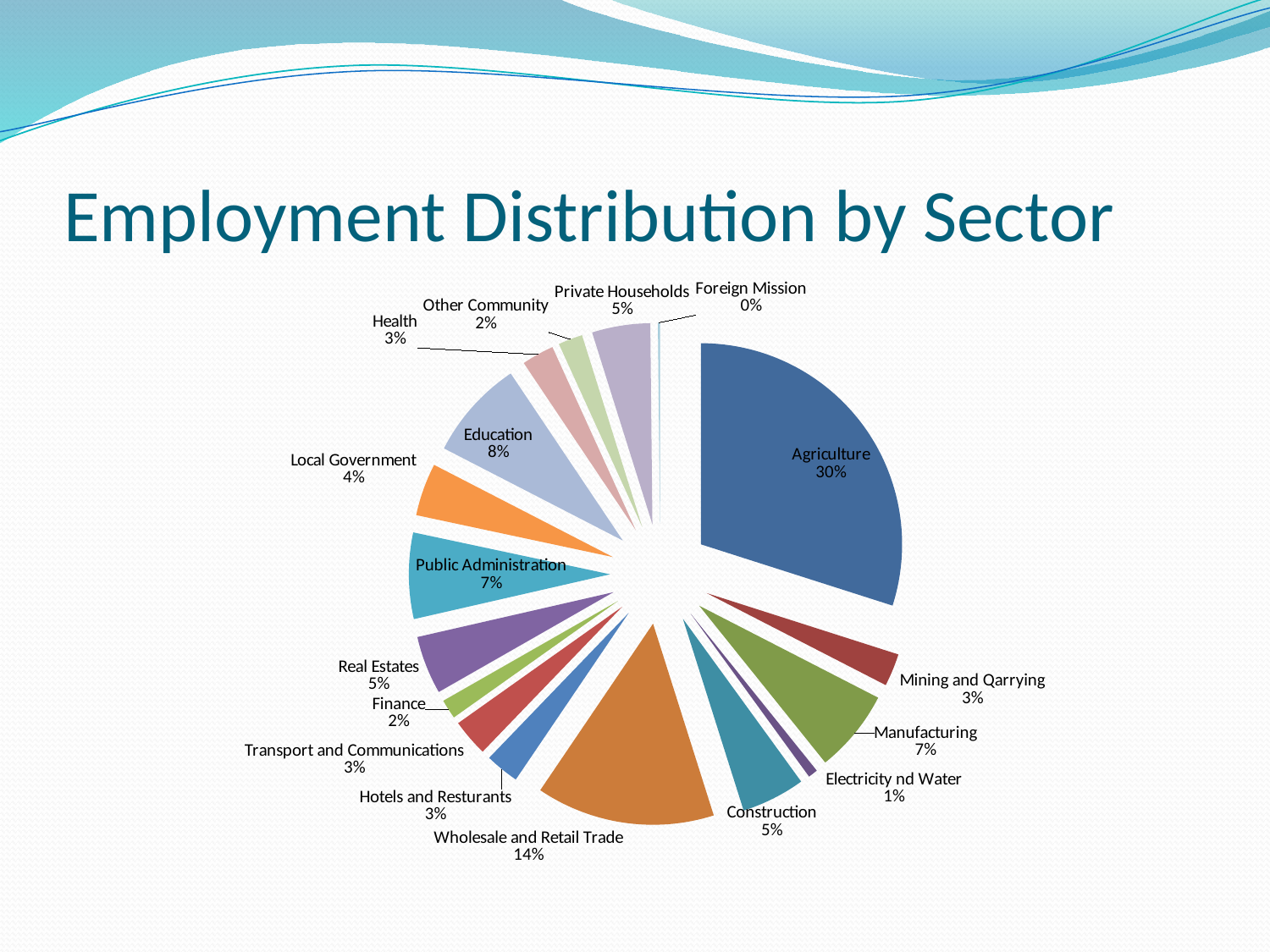
Which has a larger share, Manufacturing or Construction? Manufacturing Which sector has the smallest share of employment? Foreign Mission Which sector has the largest share of employment? Agriculture What percentage is shown for Foreign Mission? 0% What percentage is shown for Education? 8% What is the combined share of Public Administration and Local Government? 11% What is the title of the chart? Employment Distribution by Sector How many sectors are shown in the pie chart? 17 What type of chart is shown on the slide? pie chart What percentage is shown for Wholesale and Retail Trade? 14% What is the difference in percentage points between Agriculture and Wholesale and Retail Trade? 16 What share of employment does Agriculture account for? 30%